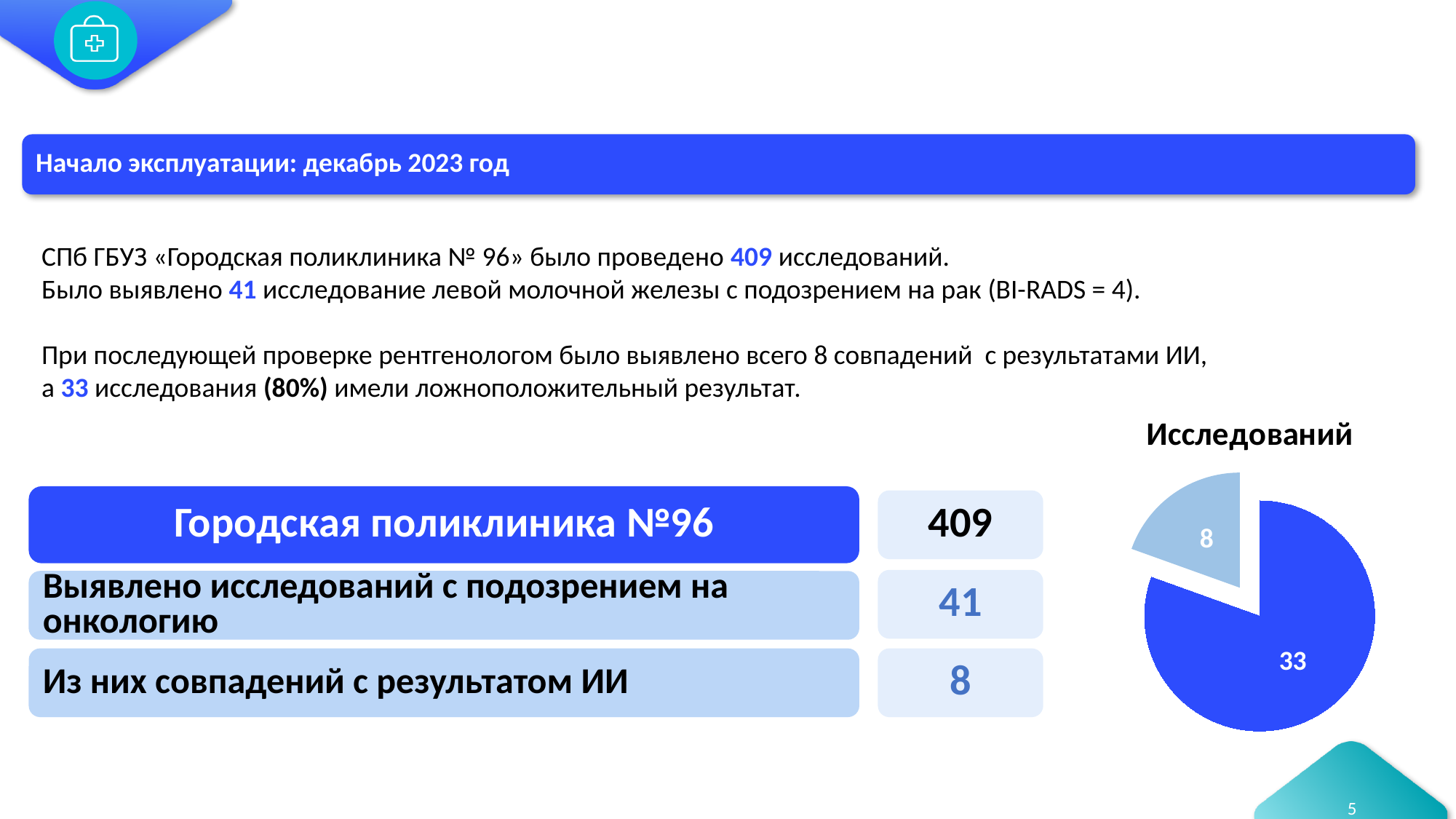
What value is labelled on the small light blue slice of the pie chart? 8 What is the title of the pie chart? Исследований Which slice of the pie chart has the lowest value? 8 How many slices does the pie chart have? 2 What kind of chart is shown on the right side of the slide? pie chart What value is labelled on the large dark blue slice of the pie chart? 33 Which slice of the pie chart is pulled out (exploded) from the rest of the pie? the light blue slice labelled 8 Which slice of the pie chart has the highest value? 33 What is the total of the two slice values in the pie chart? 41 According to the slide, what percentage share do the 33 studies represent? 80% What is the difference between the two slice values in the pie chart? 25 Which is larger in the pie chart: the dark blue slice or the light blue slice? dark blue slice (33)